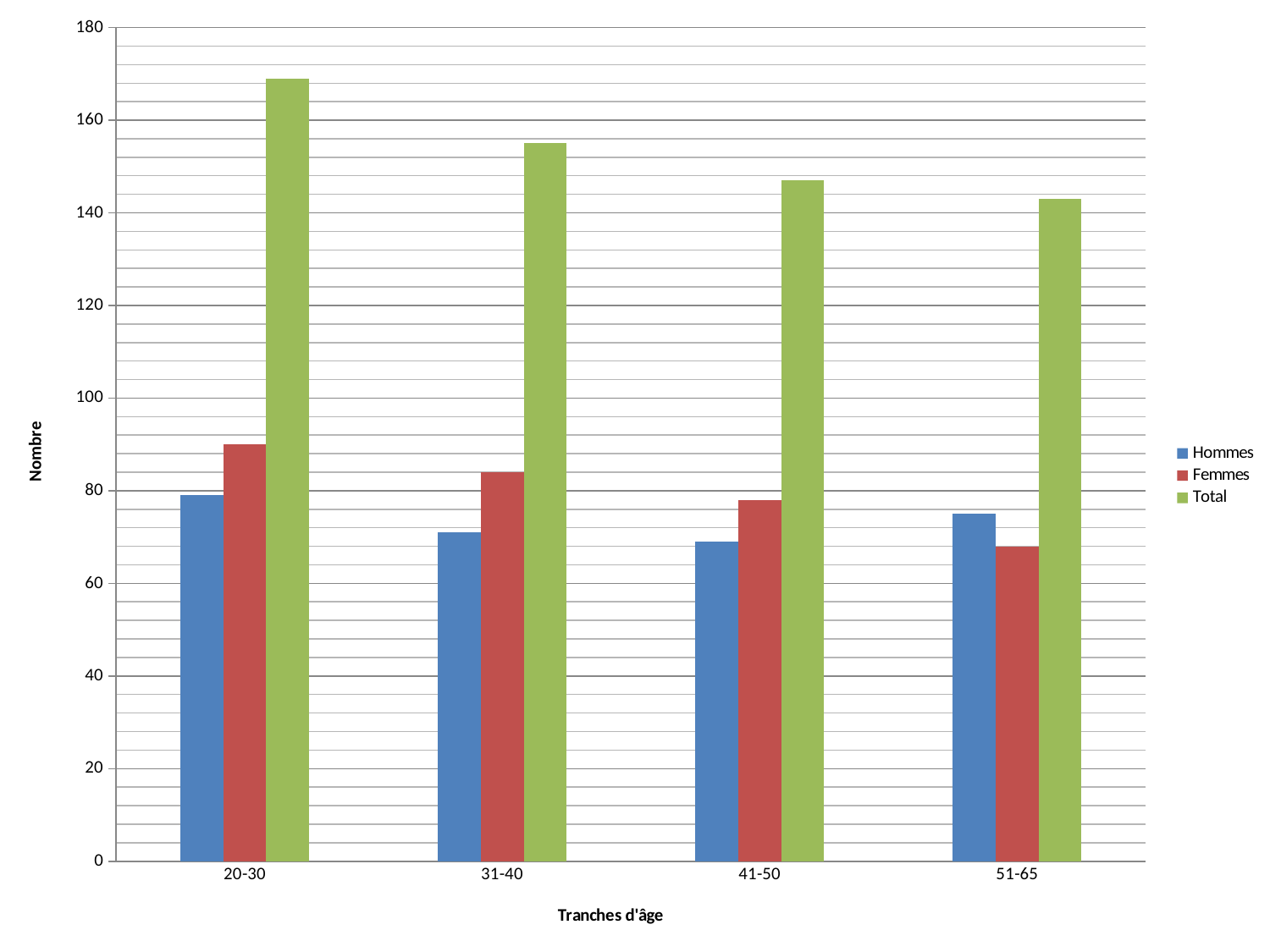
Do the Total values rise or fall as the age groups go from 20-30 to 51-65? fall Which age group has the highest Total bar? 20-30 Is the Femmes value for the 51-65 age group greater or less than 80? less How many age groups (tranches d'âge) are shown on the x axis? 4 Is the Total value for the 51-65 age group greater or less than 160? less In the 20-30 age group, which is larger, Hommes or Femmes? Femmes Is the Total value for the 20-30 age group greater or less than 160? greater Which age group has the lowest Femmes bar? 51-65 What kind of chart is shown on the slide? bar chart How many series does the legend list? 3 In the 51-65 age group, which is larger, Hommes or Femmes? Hommes